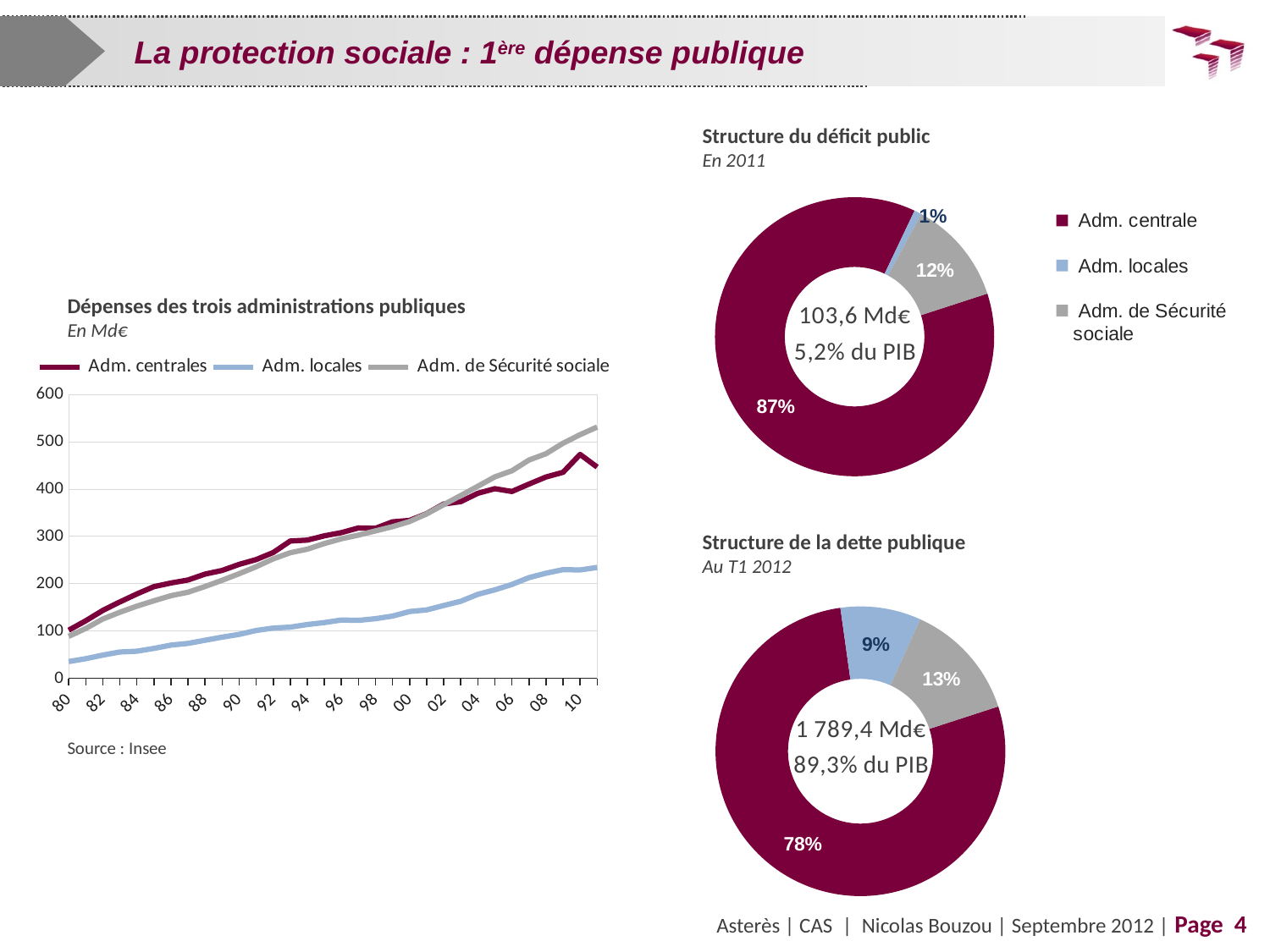
In 'Structure du déficit public', which category has the largest share? Adm. centrale In 'Dépenses des trois administrations publiques', is the value for Adm. locales in 10 greater or less than 300? less In 'Dépenses des trois administrations publiques', is the value for Adm. locales in 80 greater or less than 100? less In 'Structure de la dette publique', what share is Adm. locales? 9% What total amount is printed in the centre of 'Structure de la dette publique'? 1 789,4 Md€ In 'Dépenses des trois administrations publiques', is the value for Adm. centrales in 10 greater or less than 400? greater In 'Dépenses des trois administrations publiques', do the values for Adm. de Sécurité sociale rise or fall from 80 to 10? rise What kind of chart is 'Dépenses des trois administrations publiques'? line chart What is the difference in percentage points between the Adm. centrale share in 'Structure du déficit public' and in 'Structure de la dette publique'? 9 percentage points In 'Structure de la dette publique', what share is Adm. de Sécurité sociale? 13% In 'Structure du déficit public', which category has the smallest share? Adm. locales How many series does the legend of 'Dépenses des trois administrations publiques' list? 3